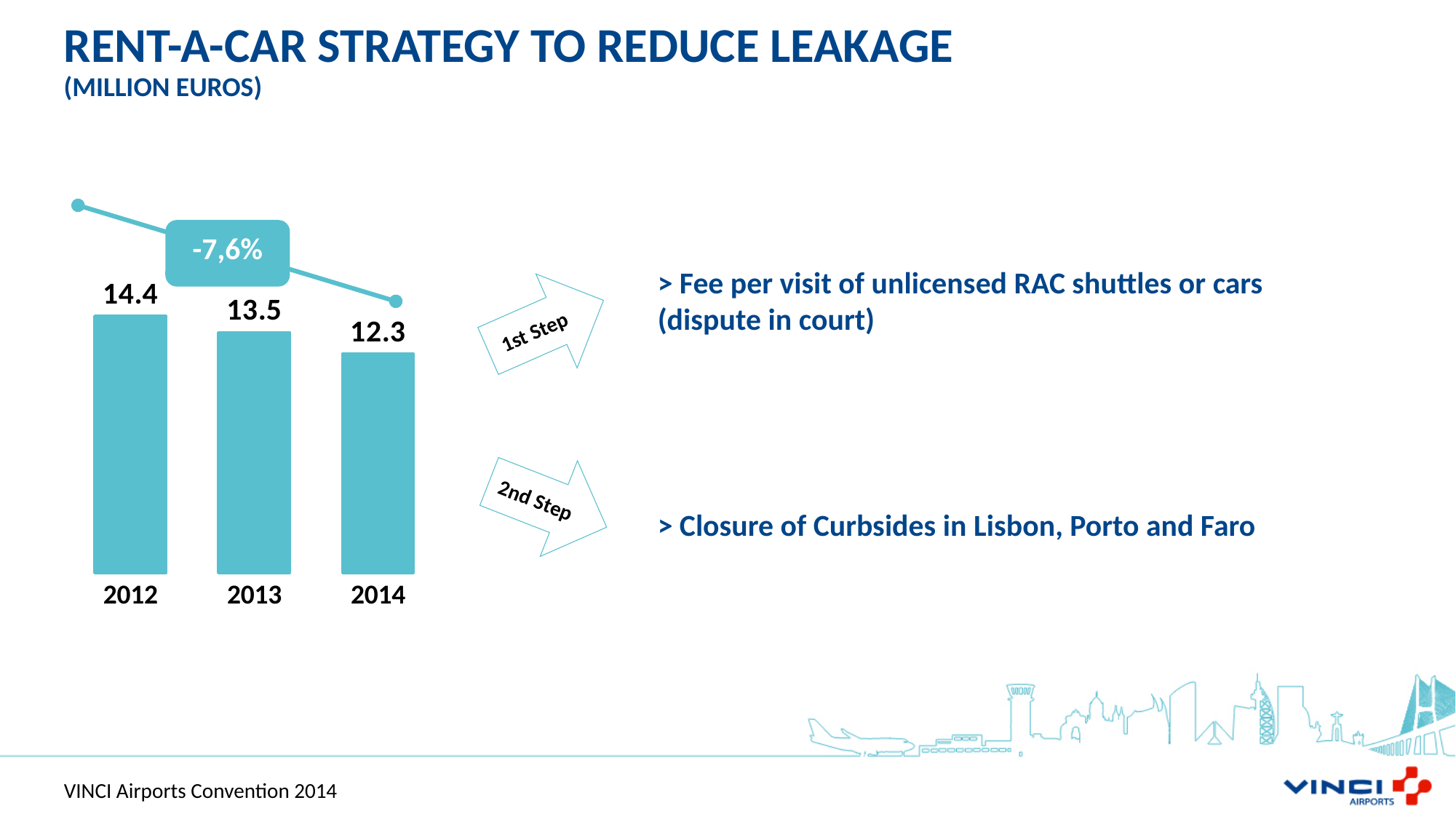
What is the value for 2012? 14.4 Which year has the lowest value? 2014 What kind of chart is shown on the slide? bar chart What is the value for 2013? 13.5 What is the difference between the values for 2012 and 2014? 2.1 What percentage change is shown in the label above the bars? -7,6% Do the values rise or fall from 2012 to 2014? fall Which is larger, the value for 2012 or the value for 2013? 2012 Which year has the highest value? 2012 How many years are shown in the chart? 3 What is the difference between the values for 2013 and 2014? 1.2 What is the value for 2014? 12.3